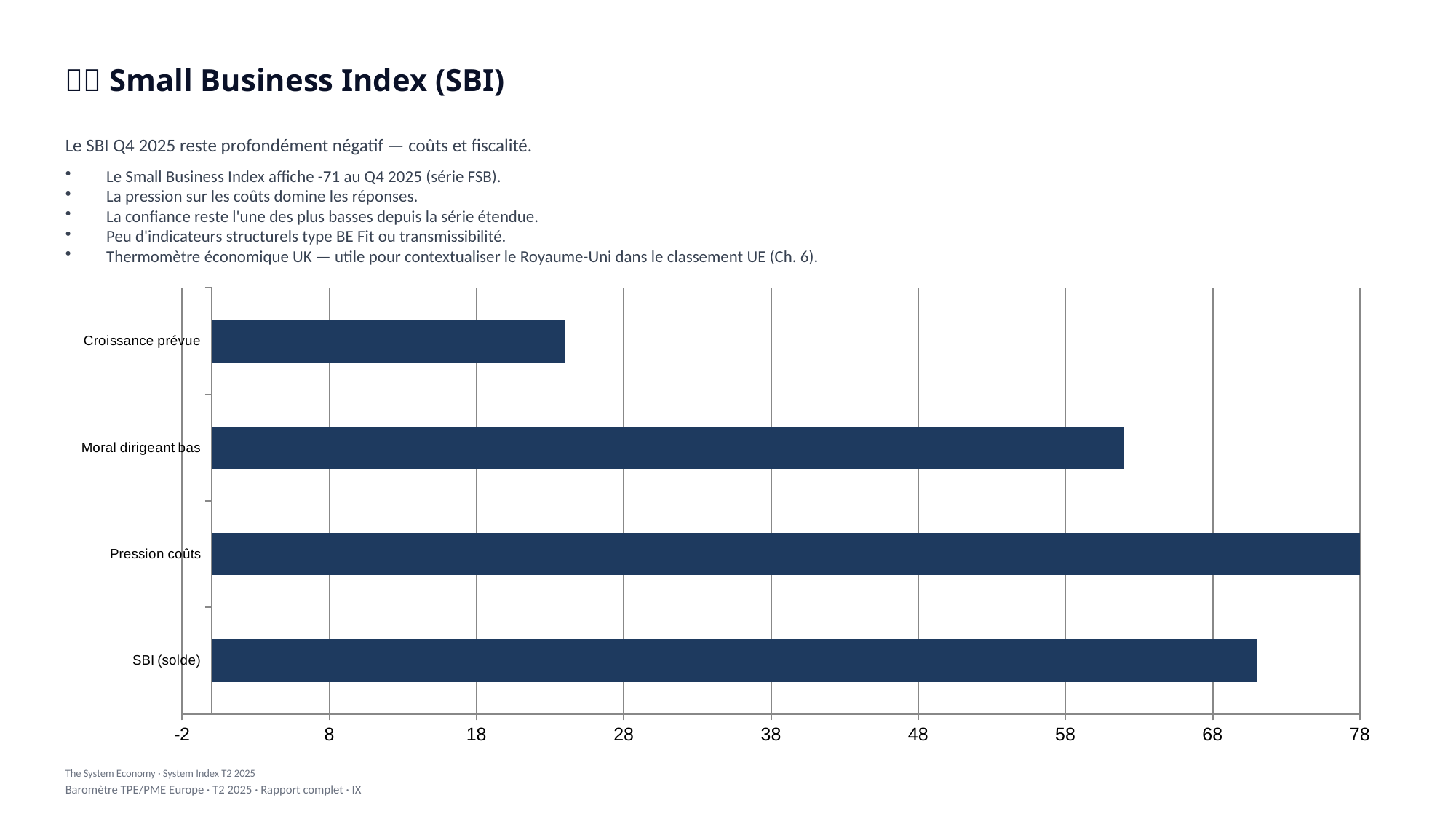
What is the value for Pression coûts? 78 Is the value for Croissance prévue greater or less than 28? less Which category has the lowest value in the chart? Croissance prévue Which is larger, the value for Moral dirigeant bas or the value for SBI (solde)? SBI (solde) How many categories are plotted in the chart? 4 Is the value for Croissance prévue greater or less than 18? greater Is the value for Moral dirigeant bas greater or less than 58? greater What type of chart is shown on the slide? bar chart What is the title of the slide containing the chart? Small Business Index (SBI) Which category has the highest value in the chart? Pression coûts